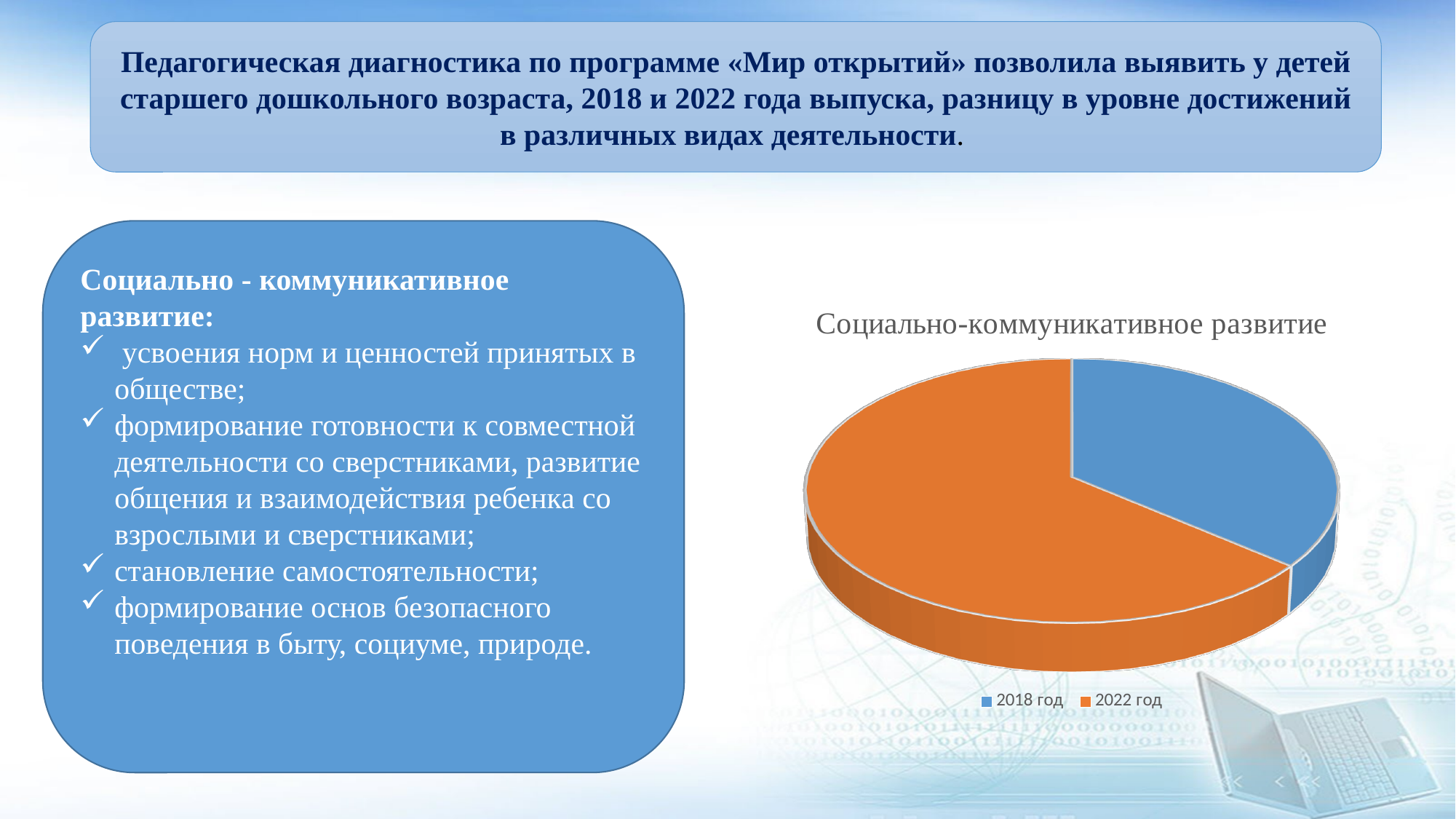
Which slice of the pie chart is the smallest? 2018 год What is the title of the chart? Социально-коммуникативное развитие How many slices does the pie chart have? 2 Which is larger in the pie chart, the slice for 2018 год or the slice for 2022 год? 2022 год Which legend entry is shown in blue? 2018 год How many entries does the chart legend list? 2 What colour is the slice for 2022 год in the pie chart? Orange Which slice of the pie chart is the largest? 2022 год What kind of chart is shown on the slide? Pie chart